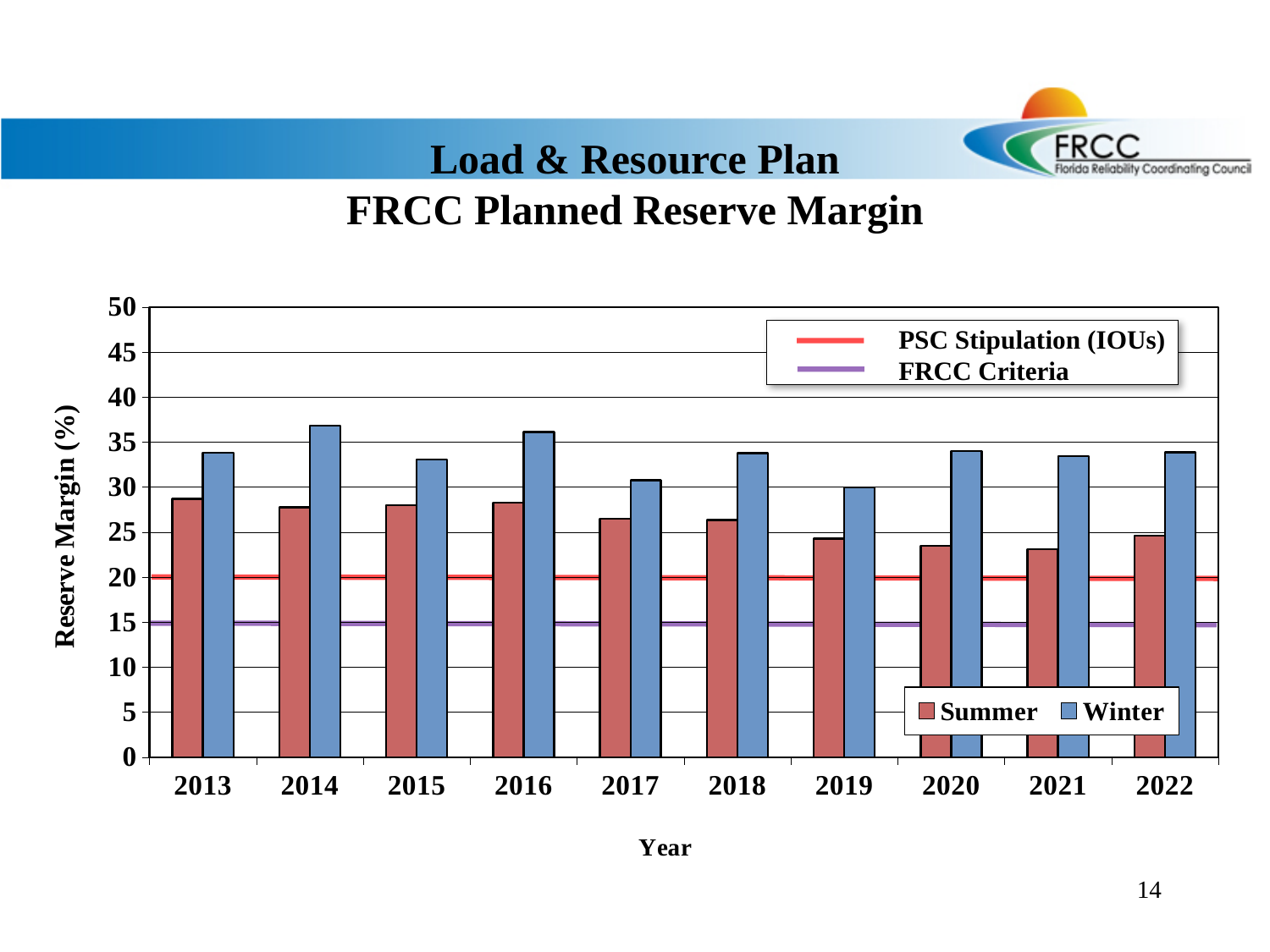
Is the Winter value for 2019 greater or less than 35? less Which is larger, the Winter value for 2014 or the Winter value for 2017? Winter 2014 Is the Summer value for 2021 greater or less than 25? less What is the title of the y axis? Reserve Margin (%) Do the Summer values rise or fall from 2016 to 2021? fall What kind of chart is shown on the slide? bar chart In 2016, which series has the larger value, Summer or Winter? Winter How many years are shown on the x axis of the chart? 10 At what reserve margin value is the FRCC Criteria line drawn? 15 At what reserve margin value is the PSC Stipulation (IOUs) line drawn? 20 Is the Winter value for 2014 greater or less than 35? greater How many series does the Summer/Winter legend list? 2